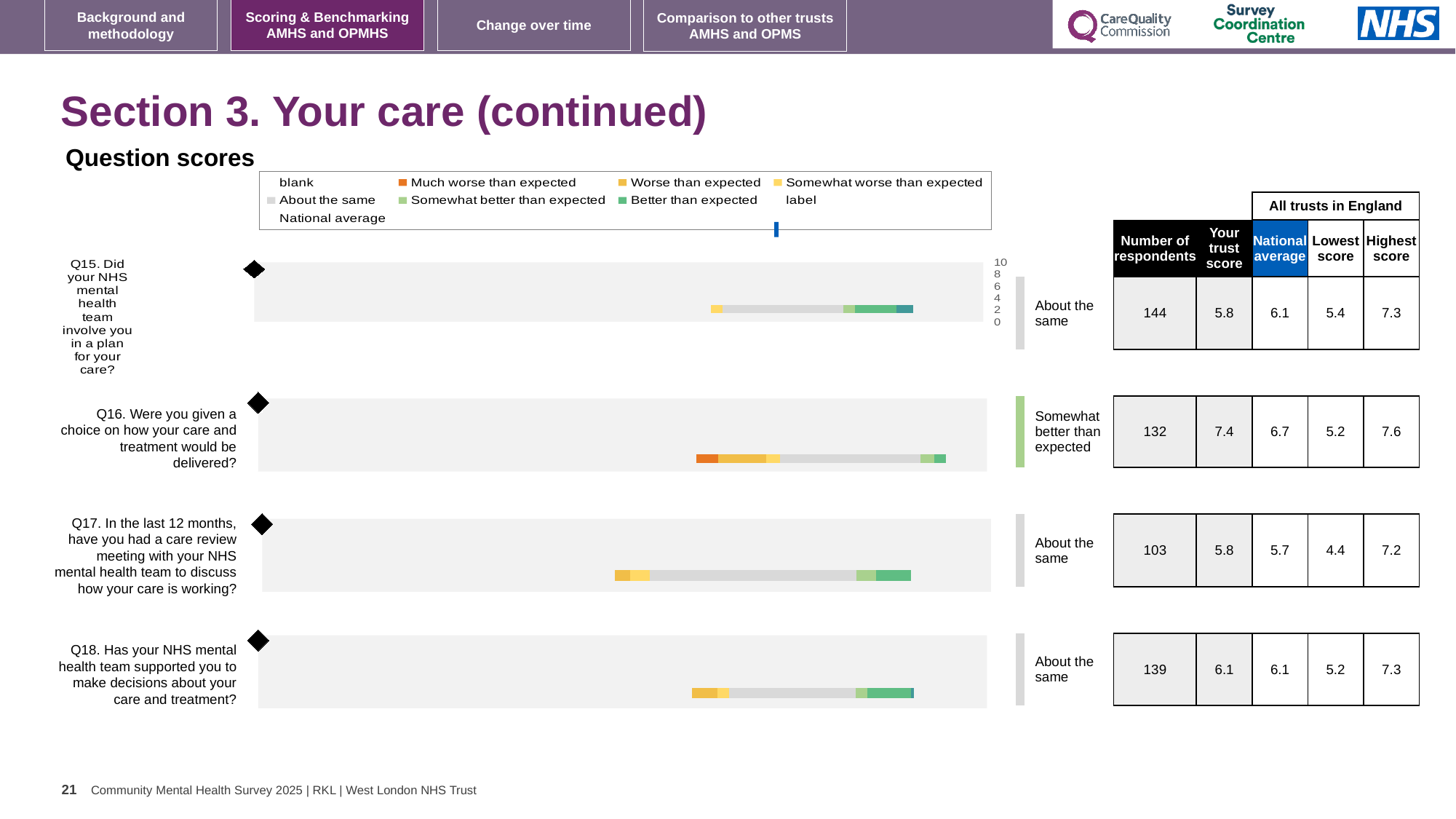
Which question is rated 'Somewhat better than expected'? Q16 What is the 'Your trust score' value shown for Q16? 7.4 For Q15, which is larger: the trust score or the national average? national average What kind of chart is used to show the question scores on this slide? bar chart What is the difference between the trust score and the national average for Q16? 0.7 What is the number of respondents shown for Q15? 144 What is the national average shown for Q17? 5.7 Which question has the highest 'Your trust score'? Q16 What is the difference between the highest score and the lowest score for Q15? 1.9 Which question has the lowest number of respondents? Q17 Which legend entry is shown in orange? Much worse than expected How many questions (Q15 to Q18) have bars plotted on the slide? 4